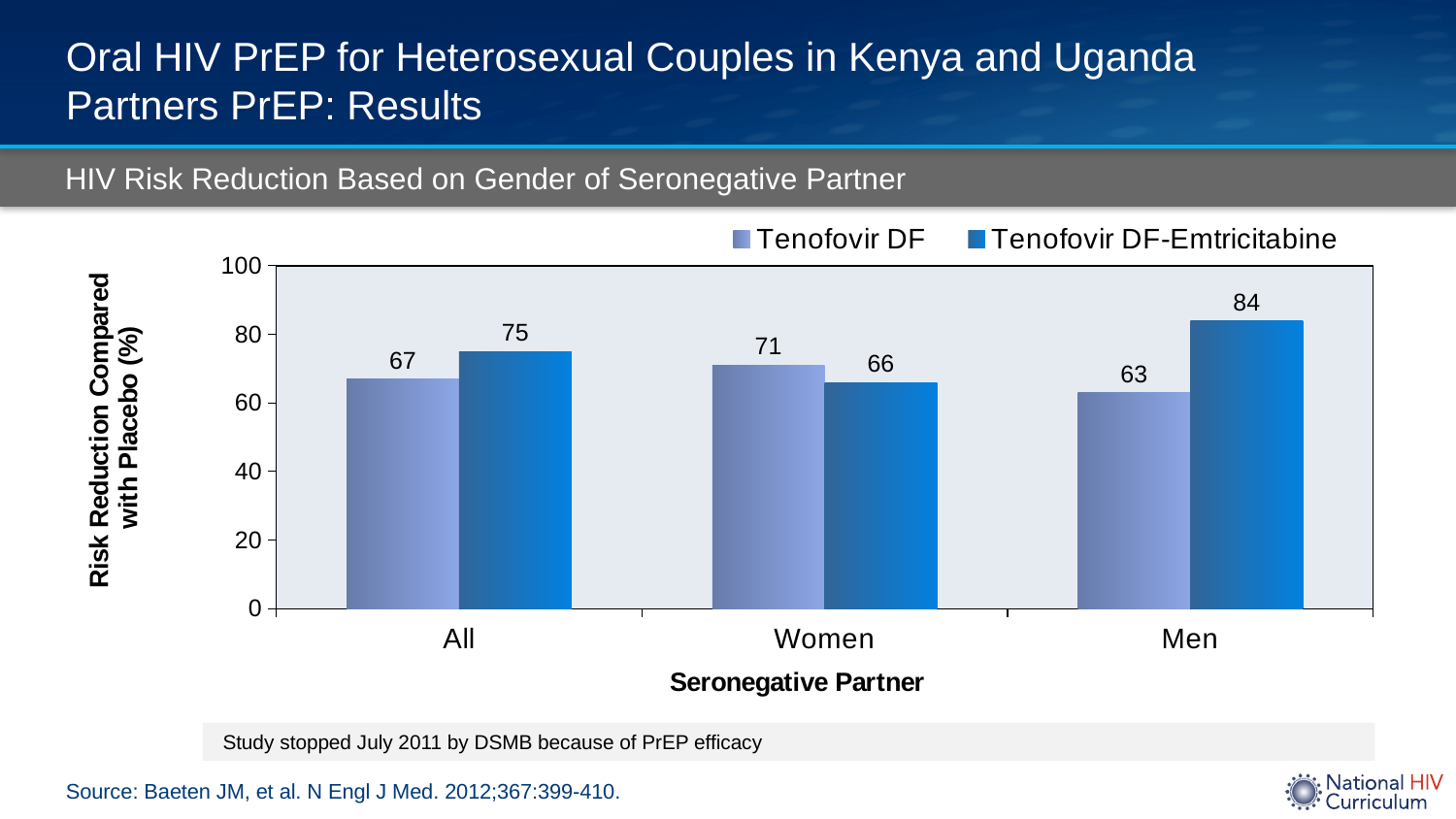
What is the label of the y axis? Risk Reduction Compared with Placebo (%) Is the Tenofovir DF-Emtricitabine value for Men greater or less than 80? greater What is the risk reduction for Tenofovir DF among Women? 71 How many series does the legend list? 2 What is the risk reduction for Tenofovir DF in the All group? 67 Which seronegative partner group has the lowest risk reduction for Tenofovir DF? Men Which is larger for Women: the Tenofovir DF value or the Tenofovir DF-Emtricitabine value? Tenofovir DF What kind of chart is shown on the slide? Bar chart What is the difference between the Tenofovir DF-Emtricitabine and Tenofovir DF values for Men? 21 What is the risk reduction for Tenofovir DF-Emtricitabine among Men? 84 Which seronegative partner group has the highest risk reduction for Tenofovir DF-Emtricitabine? Men How many seronegative partner categories are shown on the x axis? 3